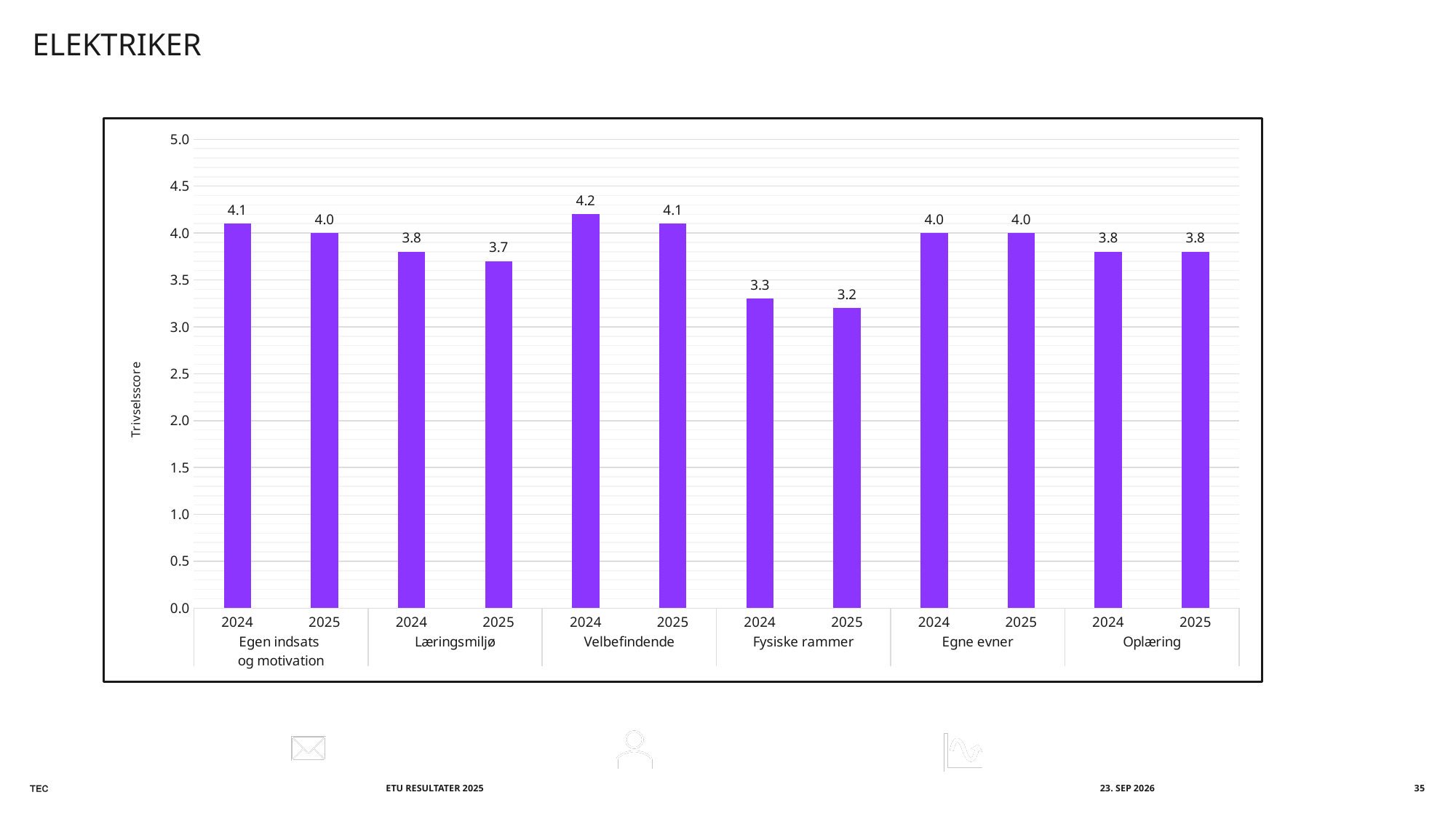
What is the Trivselsscore for Fysiske rammer in 2025? 3.2 How many bars are plotted on the chart? 12 What is the Trivselsscore for Velbefindende in 2024? 4.2 Which bar has the lowest Trivselsscore on the chart? Fysiske rammer 2025 How many category groups are shown on the x axis? 6 What is the label of the y axis? Trivselsscore What is the difference between the 2024 and 2025 Trivselsscore for Egen indsats og motivation? 0.1 What kind of chart is shown on the slide? bar chart Which is larger, the 2024 Trivselsscore for Velbefindende or the 2024 Trivselsscore for Oplæring? Velbefindende 2024 What is the Trivselsscore for Læringsmiljø in 2025? 3.7 Which bar has the highest Trivselsscore on the chart? Velbefindende 2024 Is the 2024 Trivselsscore for Fysiske rammer greater or less than 3.5? less